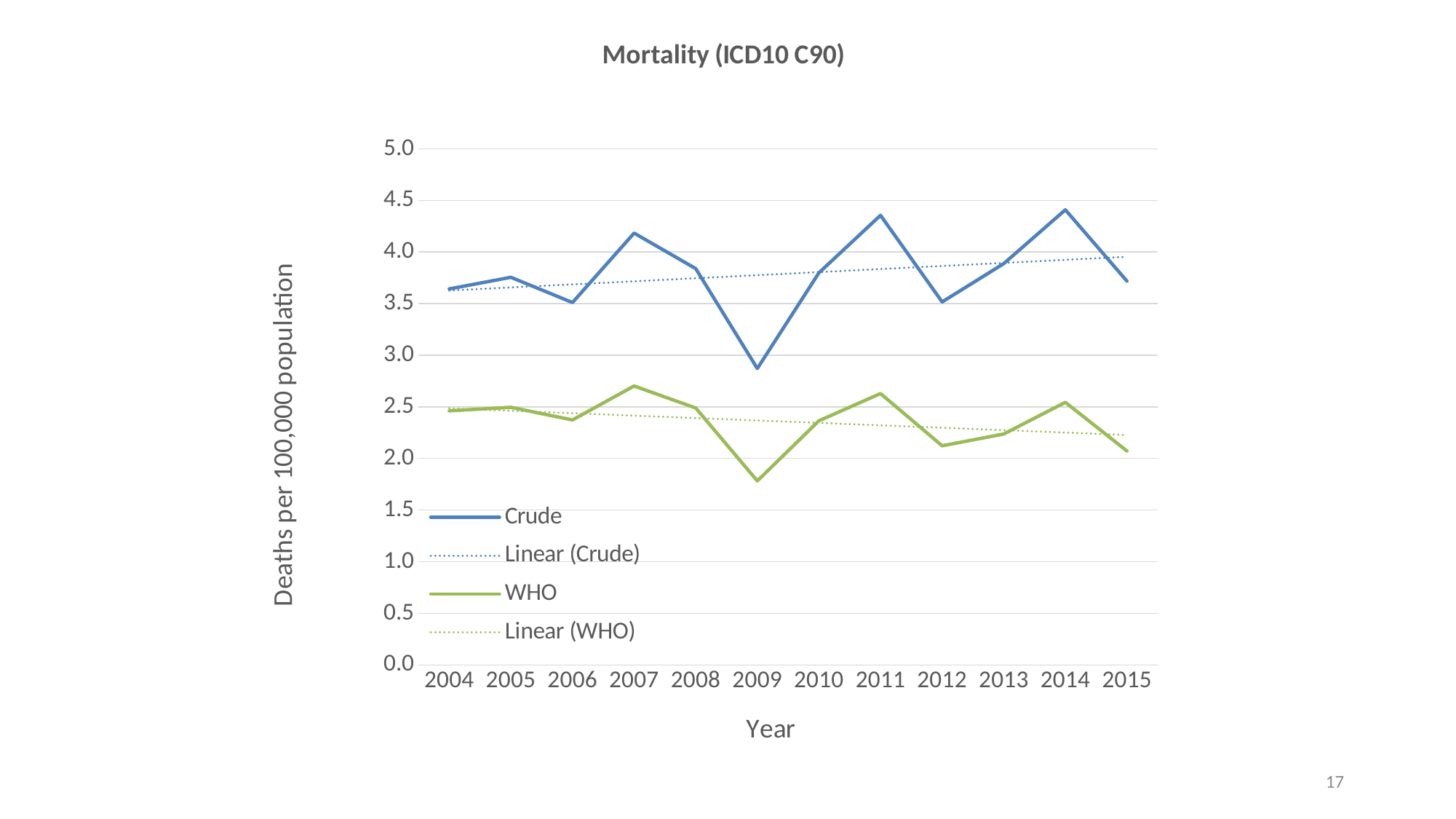
Is the WHO value for 2009 greater or less than 2.0? less How many entries does the legend list? 4 Is the Crude value for 2009 greater or less than 3.0? less What kind of chart is shown on the slide? line chart Does the Linear (WHO) trend line rise or fall from 2004 to 2015? fall In which year is the Crude mortality rate lowest? 2009 Is the WHO value for 2007 greater or less than 2.5? greater How many years are shown on the x axis? 12 In which year is the WHO mortality rate lowest? 2009 Which series has the higher value in 2014, Crude or WHO? Crude What is the title of the chart? Mortality (ICD10 C90)